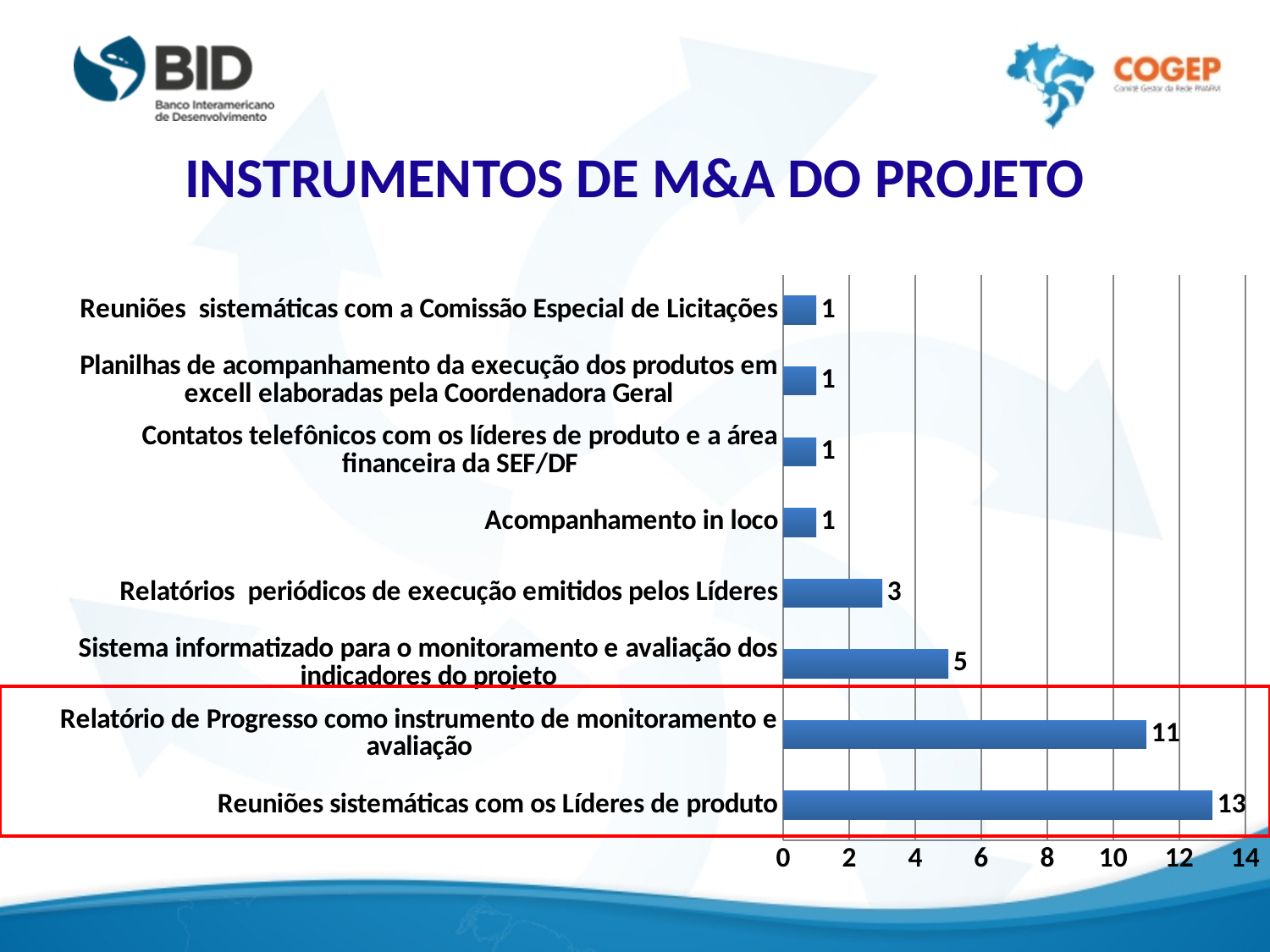
What is the value for "Acompanhamento in loco"? 1 What is the title of the slide containing the chart? INSTRUMENTOS DE M&A DO PROJETO Which category has the highest value? Reuniões sistemáticas com os Líderes de produto What is the value for "Relatórios periódicos de execução emitidos pelos Líderes"? 3 What is the difference between the values for "Reuniões sistemáticas com os Líderes de produto" and "Relatório de Progresso como instrumento de monitoramento e avaliação"? 2 Which is larger: the value for "Sistema informatizado para o monitoramento e avaliação dos indicadores do projeto" or the value for "Relatórios periódicos de execução emitidos pelos Líderes"? Sistema informatizado para o monitoramento e avaliação dos indicadores do projeto What is the value for "Relatório de Progresso como instrumento de monitoramento e avaliação"? 11 How many categories are shown in the chart? 8 How many categories have a value of 1? 4 What is the value for "Sistema informatizado para o monitoramento e avaliação dos indicadores do projeto"? 5 What kind of chart is shown on the slide? Bar chart What is the value for "Reuniões sistemáticas com os Líderes de produto"? 13